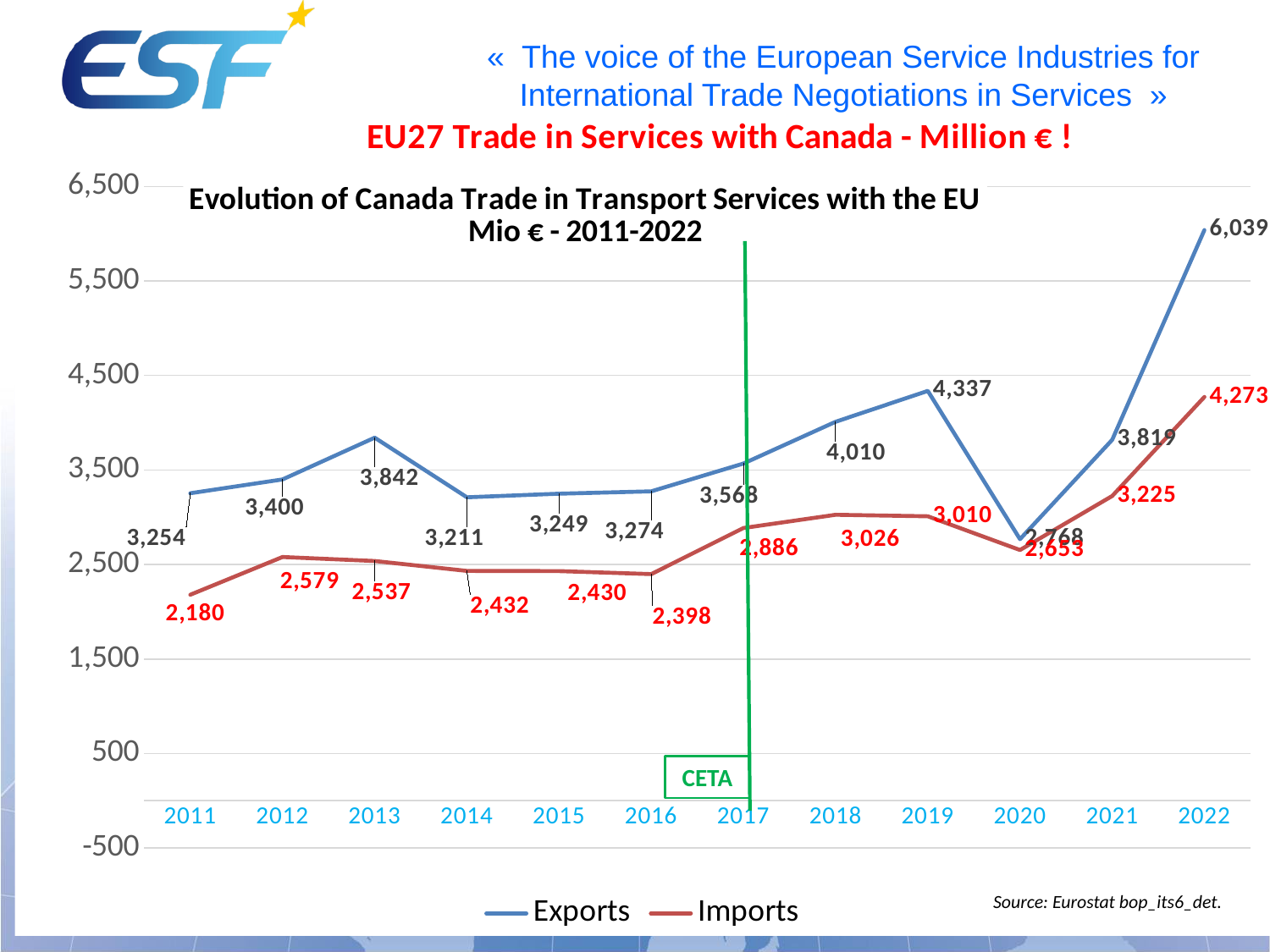
In which year are Imports lowest? 2011 Is the value for Exports in 2020 greater or less than 3,500? less Which is larger in 2013, Exports or Imports? Exports How many years are plotted along the x axis? 12 How many series does the legend list? 2 What is the value of Exports in 2019? 4,337 What is the difference between Exports and Imports in 2022? 1,766 What kind of chart is shown on the slide? line chart In which year are Exports highest? 2022 Do Exports rise or fall from 2020 to 2022? rise What is the value of Exports in 2022? 6,039 What is the value of Imports in 2011? 2,180